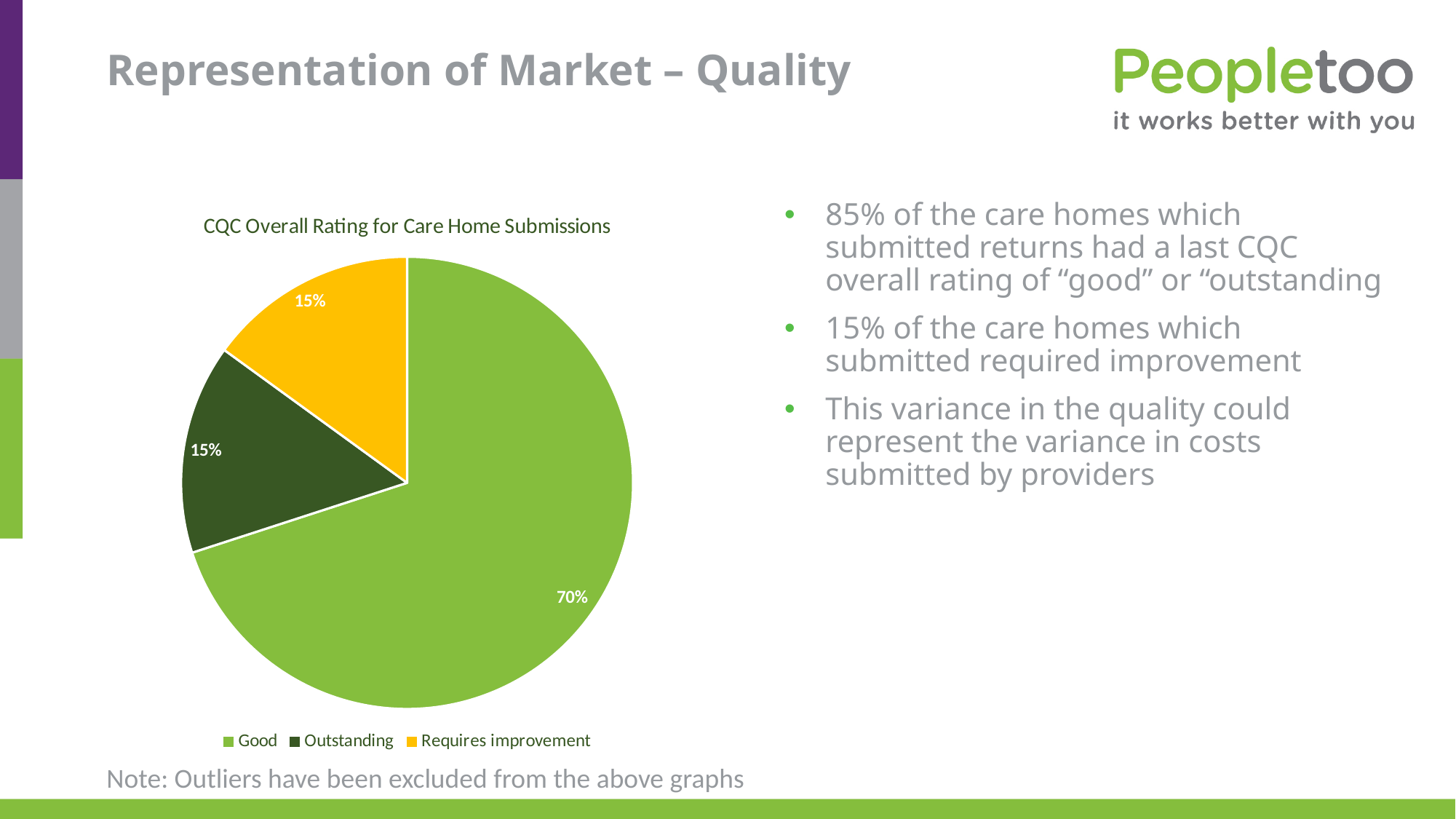
What is the combined share of the Good and Outstanding slices? 85% How many slices does the pie chart have? 3 What is the title of the chart? CQC Overall Rating for Care Home Submissions What share of the pie is labelled Requires improvement? 15% What share of the pie is labelled Good? 70% What is the difference in percentage points between the Good slice and the Outstanding slice? 55 What colour is the Requires improvement slice? Yellow What kind of chart is shown on the slide? Pie chart What share of the pie is labelled Outstanding? 15% Which category has the largest slice of the pie? Good Which is larger, the Good slice or the Requires improvement slice? Good How many categories does the legend list? 3